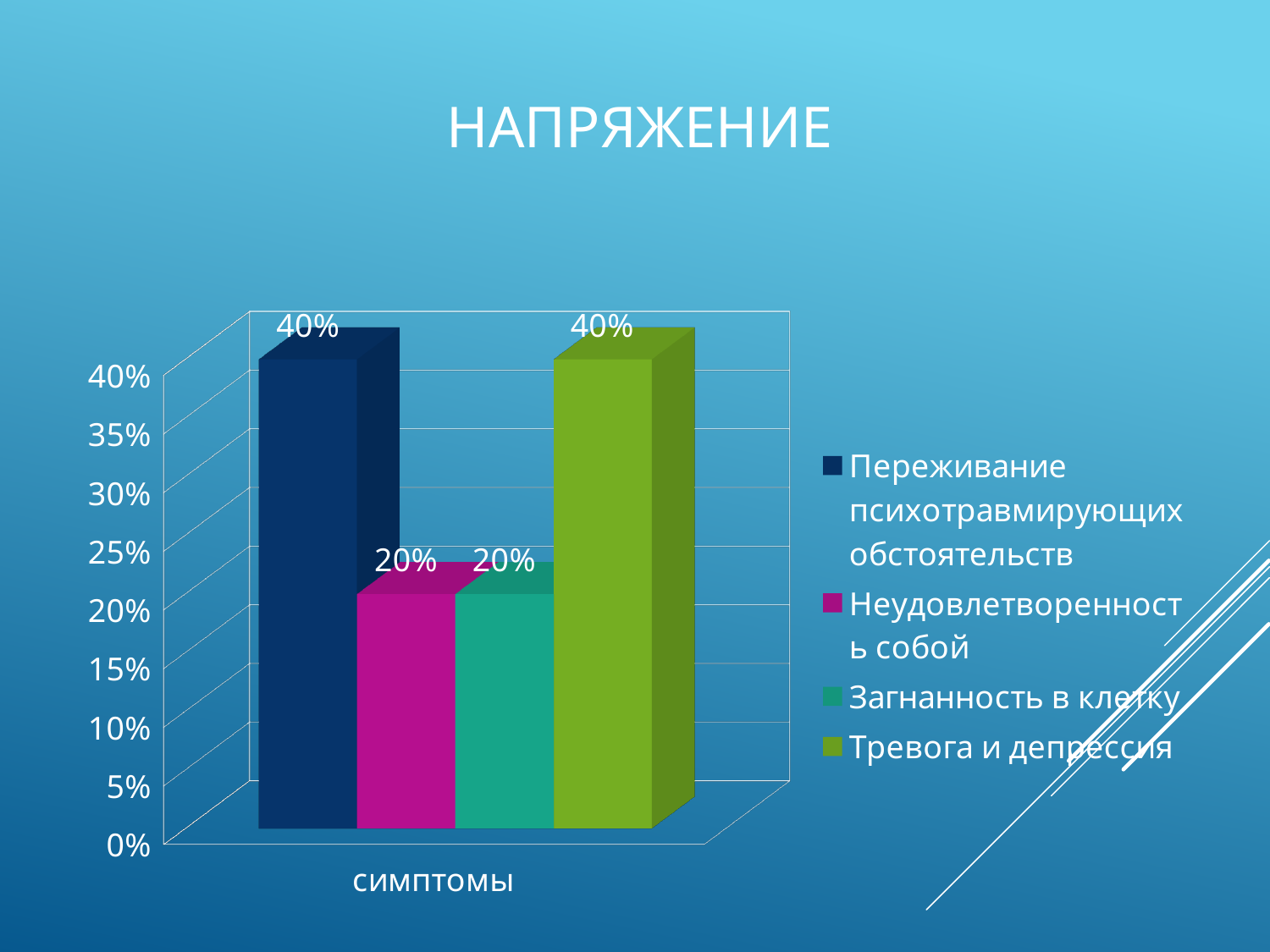
Is the value for Тревога и депрессия greater or less than 35%? greater What is the value for Тревога и депрессия? 40% Which is larger, the value for Переживание психотравмирующих обстоятельств or the value for Неудовлетворенность собой? Переживание психотравмирующих обстоятельств What kind of chart is shown on the slide? bar chart What is the value for Неудовлетворенность собой? 20% What is the value for Переживание психотравмирующих обстоятельств? 40% What is the difference between the values for Тревога и депрессия and Загнанность в клетку? 20% How many series does the legend list? 4 Is the value for Неудовлетворенность собой greater or less than 30%? less How many categories are shown on the x axis? 1 What is the value for Загнанность в клетку? 20% What is the title of the slide? НАПРЯЖЕНИЕ